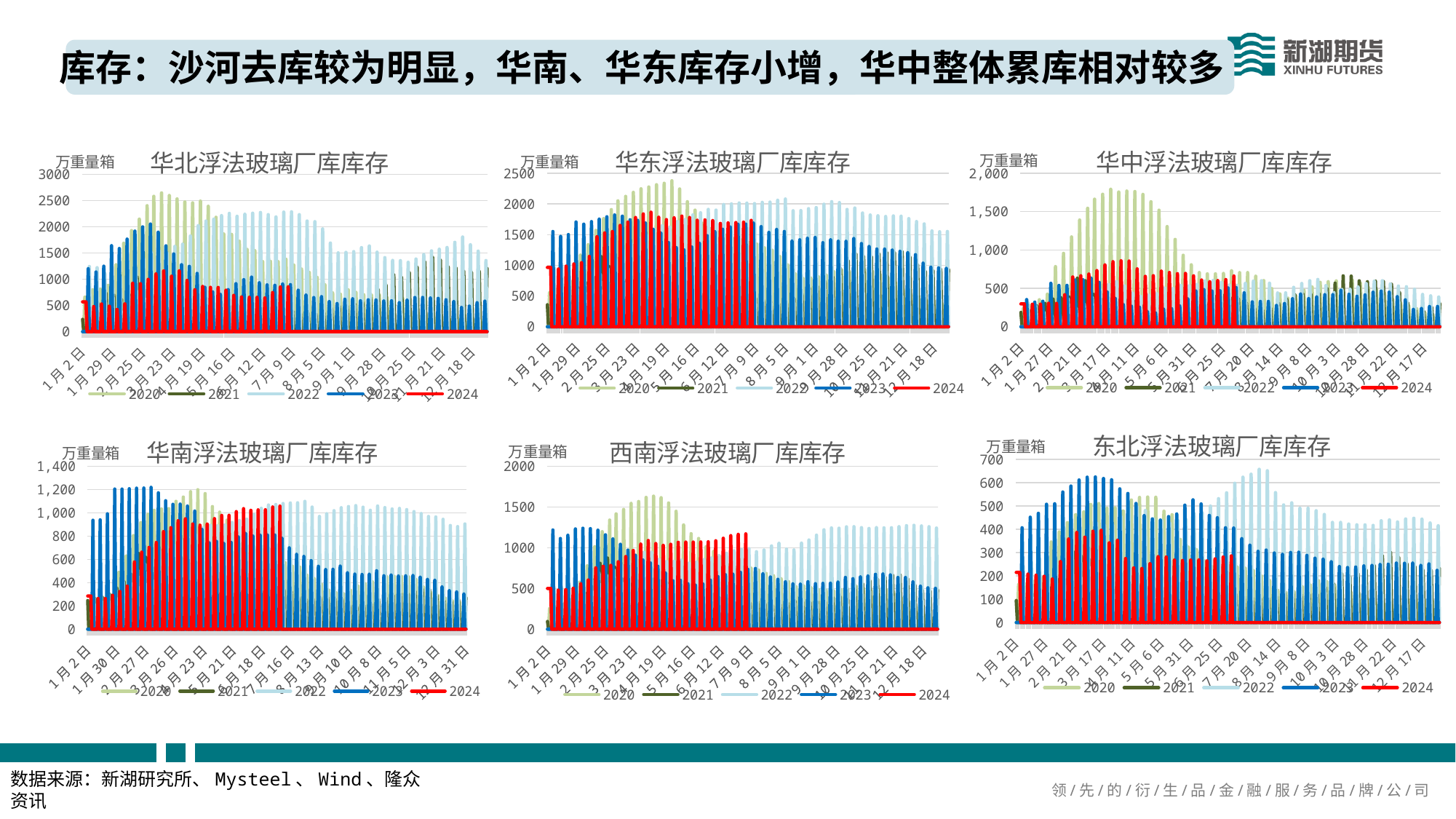
What unit is shown on the y axis of the 东北浮法玻璃厂库库存 chart? 万重量箱 In the 华东浮法玻璃厂库库存 chart, is the peak value of the 2024 series greater or less than 1500? greater In the 华中浮法玻璃厂库库存 chart, is the peak value of the 2020 series greater or less than 1,500? greater In the 华北浮法玻璃厂库库存 chart, how many series does the legend list? 5 In the 华南浮法玻璃厂库库存 chart, which colour represents the 2024 series? red In the 华中浮法玻璃厂库库存 chart, which year's series reaches the highest peak? 2020 What kind of chart is the 华东浮法玻璃厂库库存 chart? bar chart In the 西南浮法玻璃厂库库存 chart, is the peak value of the 2020 series greater or less than 1000? greater How many charts are shown on the slide? 6 In the 西南浮法玻璃厂库库存 chart, which year's series reaches the highest peak? 2020 In the 华北浮法玻璃厂库库存 chart, which year's series reaches the highest peak? 2020